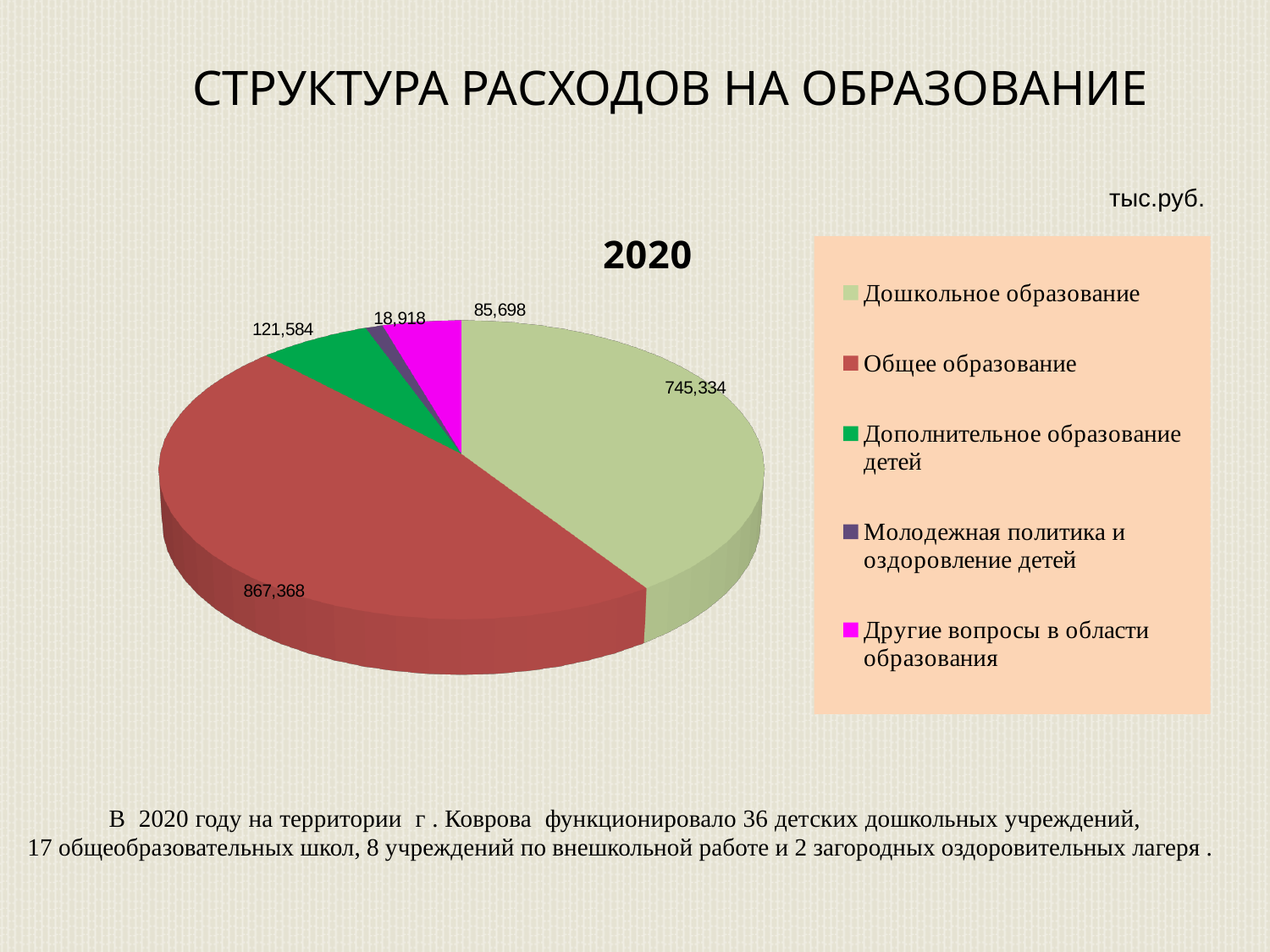
Which category has the smallest slice in the pie chart? Молодежная политика и оздоровление детей What is the value for Общее образование in the 2020 pie chart? 867,368 What is the value for Дополнительное образование детей? 121,584 How many categories does the pie chart have? 5 Which is larger: Дополнительное образование детей or Другие вопросы в области образования? Дополнительное образование детей What unit is indicated for the values in the chart? тыс.руб. What is the value for Дошкольное образование in the 2020 pie chart? 745,334 What is the difference between the values for Общее образование and Дошкольное образование? 122,034 What is the value for Молодежная политика и оздоровление детей? 18,918 What type of chart is shown on the slide? Pie chart What is the value for Другие вопросы в области образования? 85,698 Which category has the largest slice in the pie chart? Общее образование